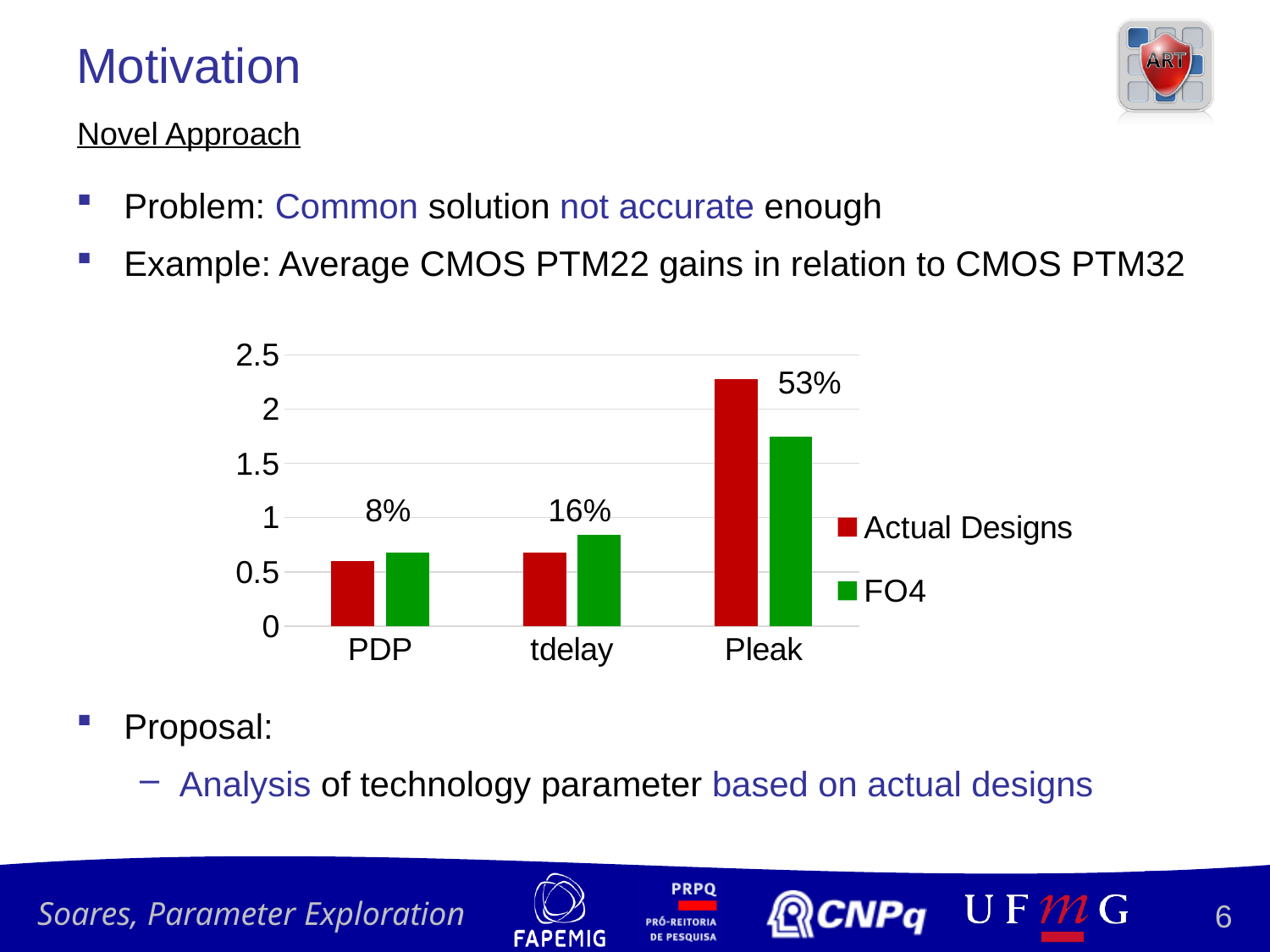
Is the FO4 value for Pleak greater or less than 1.5? greater Which category has the highest Actual Designs bar? Pleak For tdelay, which is larger: Actual Designs or FO4? FO4 Which category has the lowest FO4 bar? PDP What kind of chart is shown on the slide? bar chart Is the FO4 value for tdelay greater or less than 1? less How many series does the chart's legend list? 2 What colour represents the FO4 series in the chart? green How many categories are shown on the x axis of the chart? 3 For Pleak, which is larger: Actual Designs or FO4? Actual Designs What percentage label is shown above the Pleak bars? 53% Is the Actual Designs value for Pleak greater or less than 2? greater